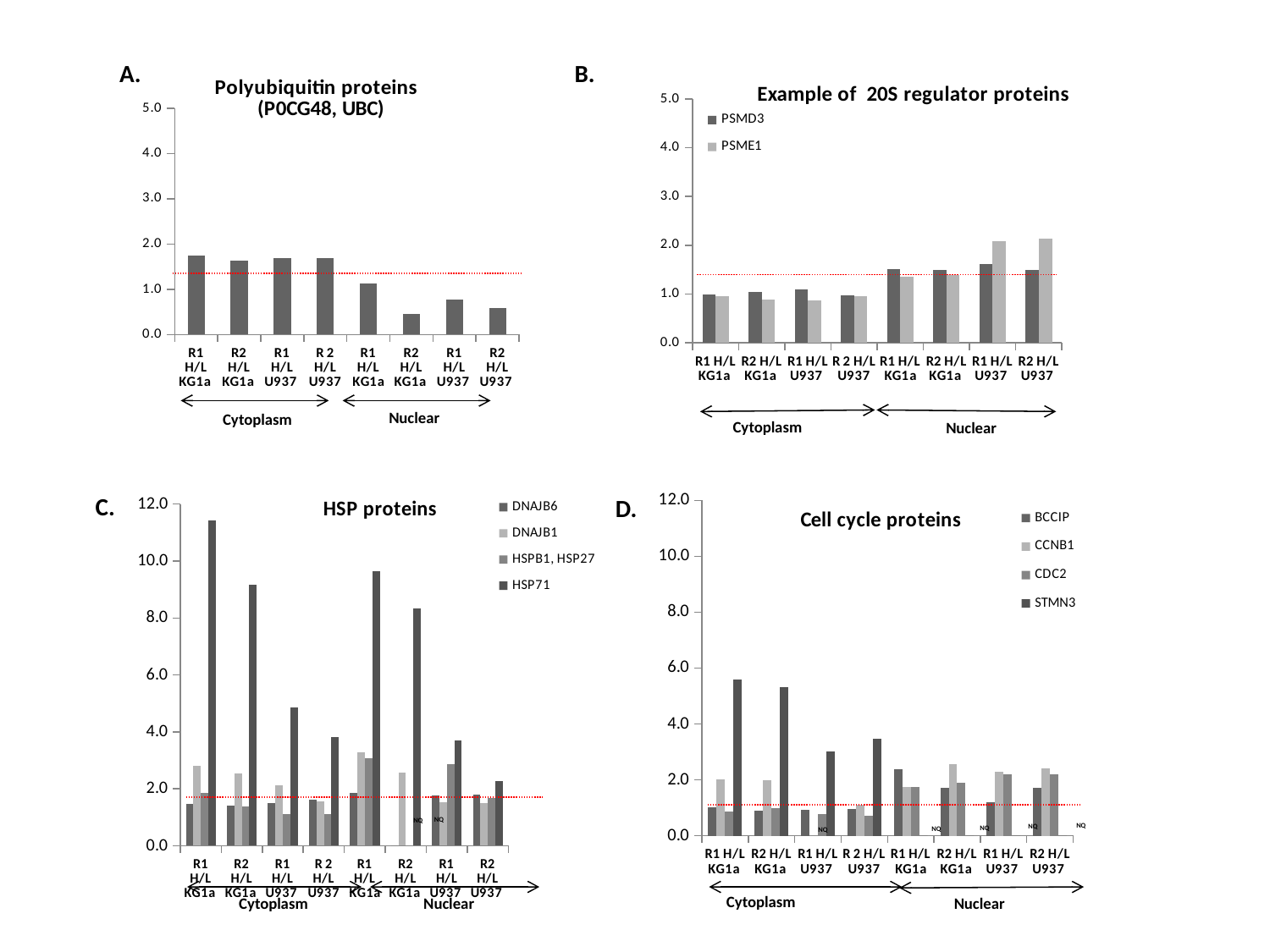
How many series does the legend of the 'HSP proteins' chart list? 4 In the 'Polyubiquitin proteins (P0CG48, UBC)' chart, which is larger: Cytoplasm R1 H/L KG1a or Nuclear R2 H/L KG1a? Cytoplasm R1 H/L KG1a In the 'HSP proteins' chart, which category has the highest HSP71 value? Cytoplasm R1 H/L KG1a In the 'Polyubiquitin proteins (P0CG48, UBC)' chart, which category has the lowest value? Nuclear R2 H/L KG1a In the 'Polyubiquitin proteins (P0CG48, UBC)' chart, is the value for Nuclear R2 H/L KG1a greater or less than 1.0? less How many series does the legend of the 'Example of 20S regulator proteins' chart list? 2 In the 'Example of 20S regulator proteins' chart, is the PSME1 value for Cytoplasm R2 H/L KG1a greater or less than 1.0? less In the 'Example of 20S regulator proteins' chart, is the PSME1 value for Nuclear R2 H/L U937 greater or less than 2.0? greater What type of chart is the 'Polyubiquitin proteins (P0CG48, UBC)' chart? bar chart In the 'Polyubiquitin proteins (P0CG48, UBC)' chart, how many bars (categories) are plotted? 8